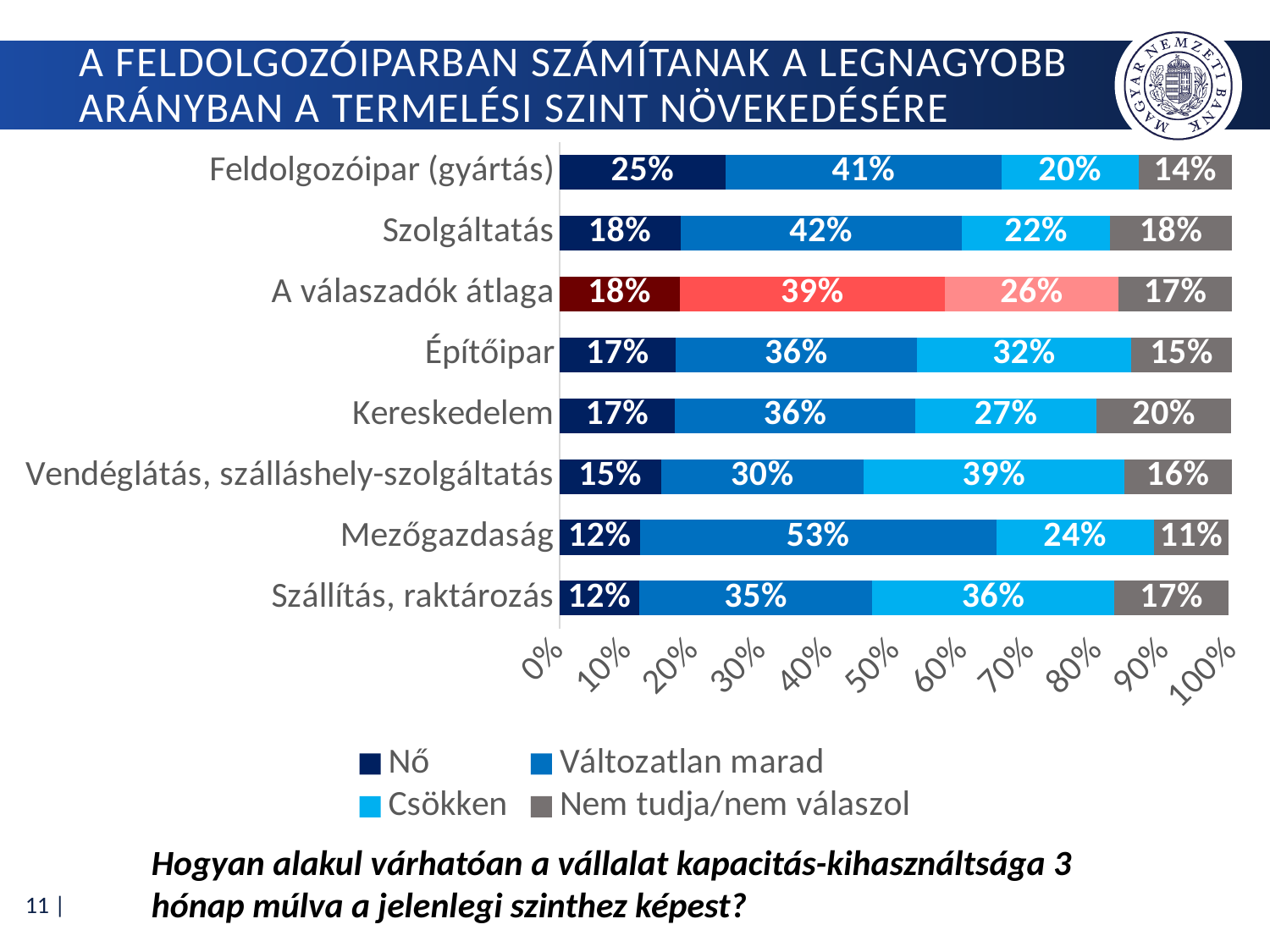
What is the 'Csökken' value for Vendéglátás, szálláshely-szolgáltatás? 39% What is the 'Nem tudja/nem válaszol' value for Kereskedelem? 20% Which category has the lowest 'Nem tudja/nem válaszol' value? Mezőgazdaság What is the total of the stacked bar for Szállítás, raktározás? 100% Which is larger: the 'Csökken' value for Építőipar or for Szolgáltatás? Építőipar How many categories are shown on the chart? 8 What is the difference between the 'Változatlan marad' values for Mezőgazdaság and Vendéglátás, szálláshely-szolgáltatás? 23% How many series does the legend list? 4 What is the 'Nő' value for Feldolgozóipar (gyártás)? 25% What kind of chart is shown on the slide? Stacked bar chart What is the 'Változatlan marad' value for Mezőgazdaság? 53% Which category has the highest 'Nő' value? Feldolgozóipar (gyártás)